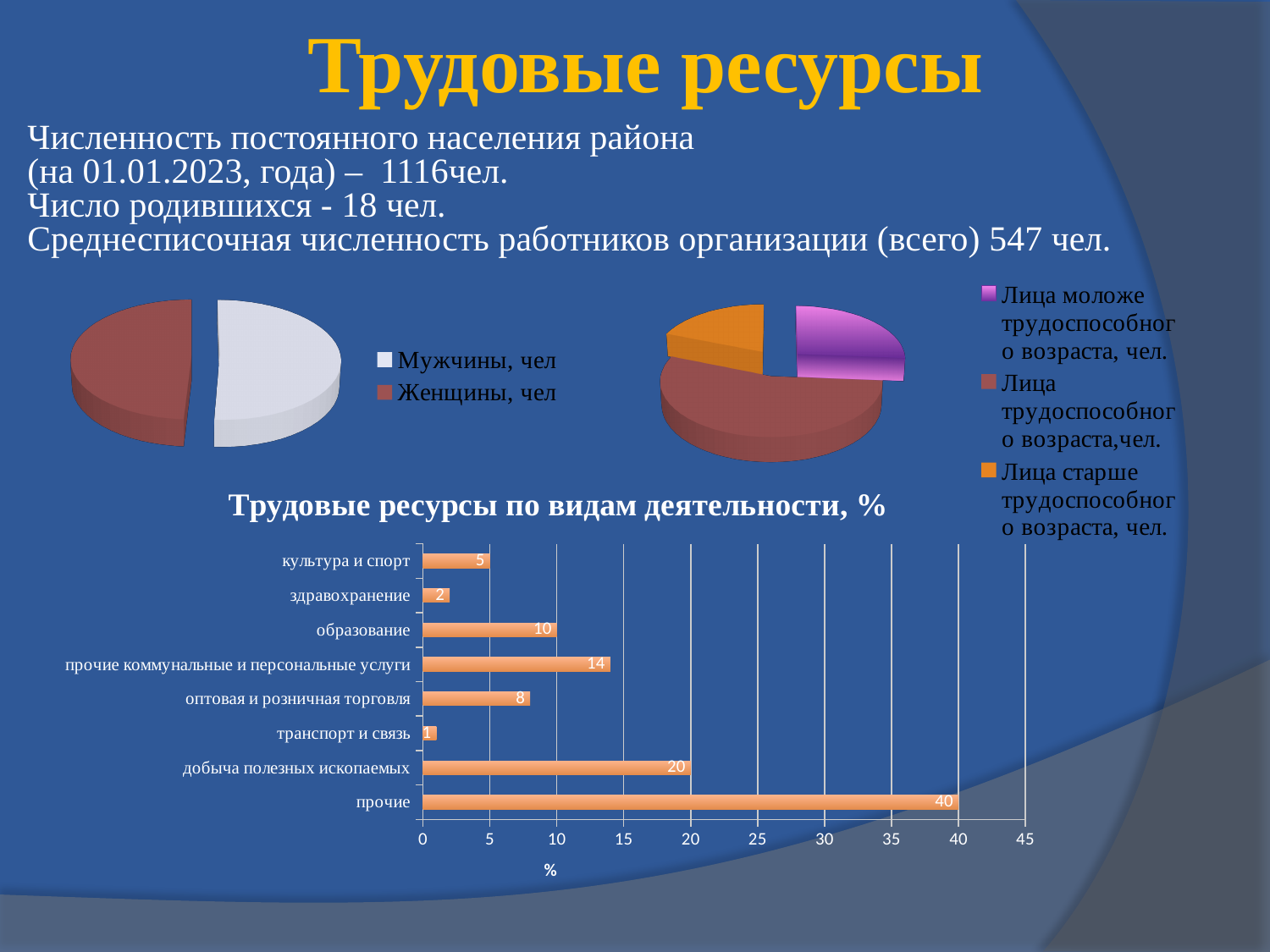
In the bar chart 'Трудовые ресурсы по видам деятельности, %', which category has the highest value? прочие In the bar chart 'Трудовые ресурсы по видам деятельности, %', how many categories are shown? 8 In the bar chart 'Трудовые ресурсы по видам деятельности, %', what is the difference between the values for 'здравоохранение' and 'транспорт и связь'? 1 In the bar chart 'Трудовые ресурсы по видам деятельности, %', what is the value for 'образование'? 10 How many series does the legend of the pie chart on the right (next to the legend starting 'Лица моложе трудоспособного возраста') list? 3 In the bar chart 'Трудовые ресурсы по видам деятельности, %', what is the value for 'прочие коммунальные и персональные услуги'? 14 In the bar chart 'Трудовые ресурсы по видам деятельности, %', what is the value for 'добыча полезных ископаемых'? 20 In the bar chart 'Трудовые ресурсы по видам деятельности, %', which is larger: 'оптовая и розничная торговля' or 'культура и спорт'? оптовая и розничная торговля What kind of chart is 'Трудовые ресурсы по видам деятельности, %'? bar chart In the bar chart 'Трудовые ресурсы по видам деятельности, %', which category has the lowest value? транспорт и связь In the pie chart on the right, which slice is the largest? Лица трудоспособного возраста, чел. In the bar chart 'Трудовые ресурсы по видам деятельности, %', what is the difference between the values for 'прочие' and 'добыча полезных ископаемых'? 20